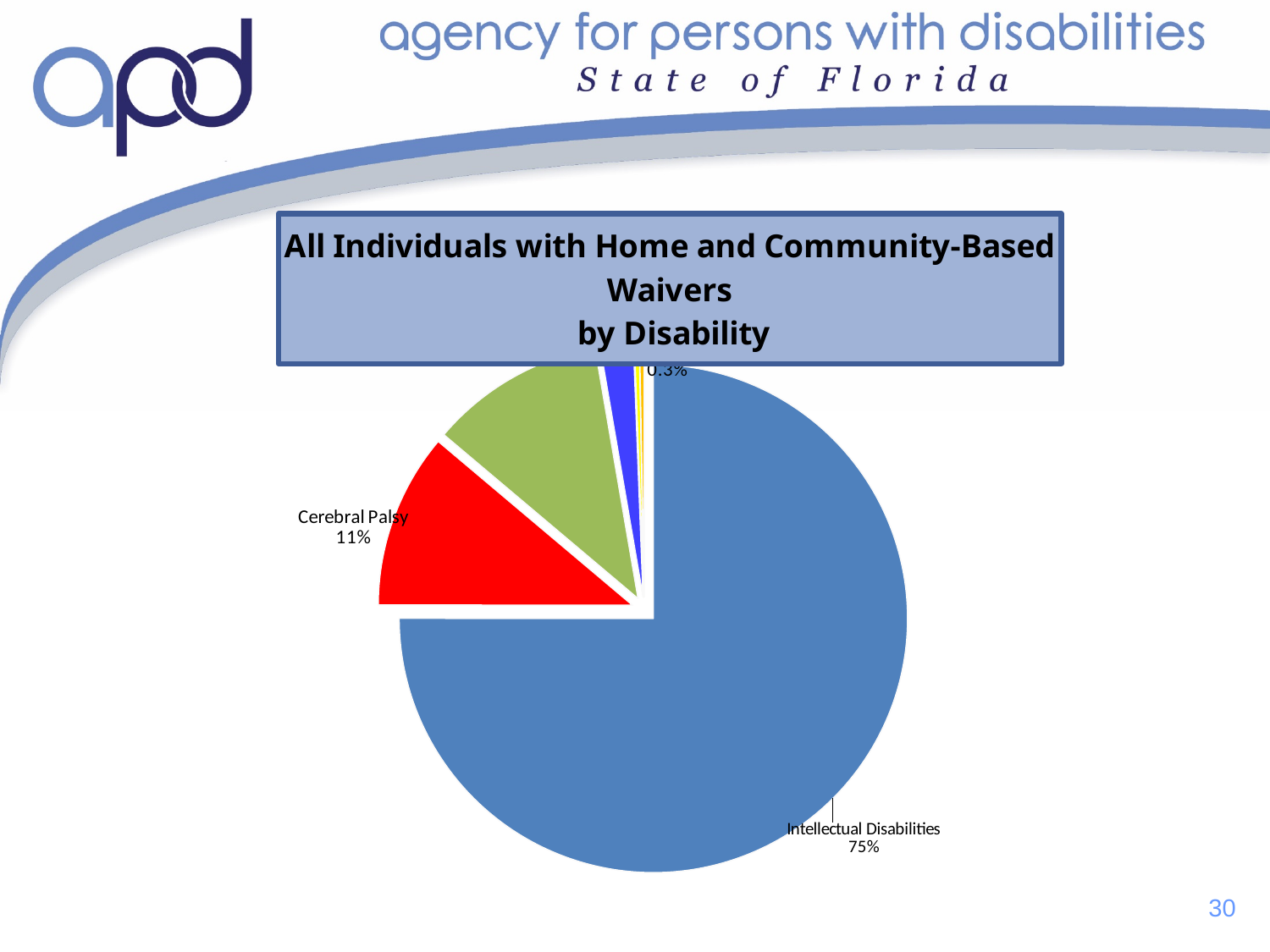
Is the share for Intellectual Disabilities greater or less than 50%? greater What share of individuals with Home and Community-Based Waivers have Cerebral Palsy? 11% What share of individuals with Home and Community-Based Waivers have Intellectual Disabilities? 75% What is the title of the chart? All Individuals with Home and Community-Based Waivers by Disability Which disability category has the largest slice of the pie? Intellectual Disabilities By how many percentage points does the Intellectual Disabilities share exceed the Cerebral Palsy share? 64 percentage points Is the share for Cerebral Palsy greater or less than 20%? less What kind of chart is shown on the slide? Pie chart What colour is the Cerebral Palsy slice? Red Which is larger, the share for Intellectual Disabilities or the share for Cerebral Palsy? Intellectual Disabilities